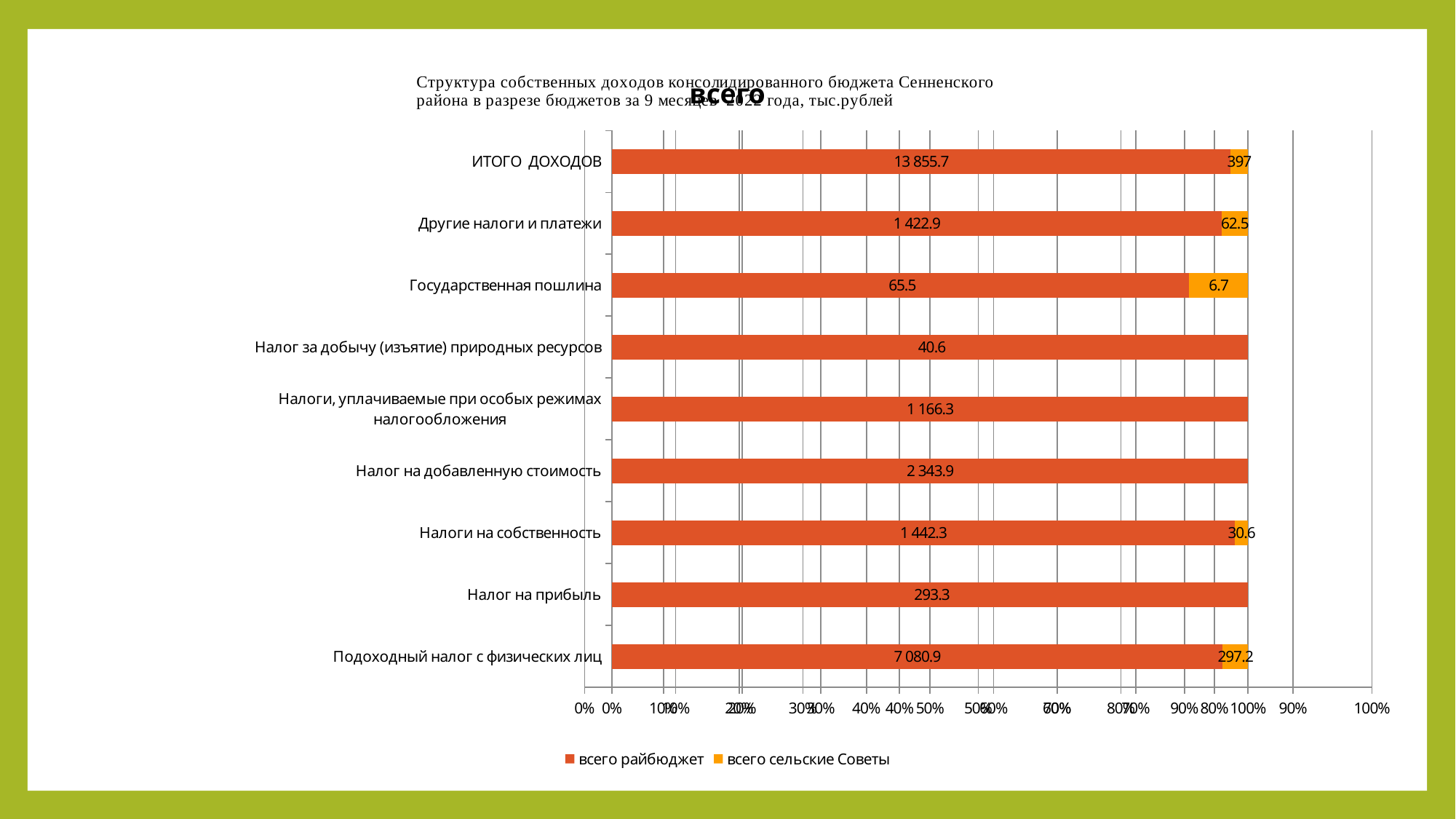
What is the value of 'всего сельские Советы' for 'Налоги на собственность'? 30.6 Which series is shown in yellow in the legend? всего сельские Советы How many categories are plotted on the chart? 9 What is the value of 'всего сельские Советы' for 'ИТОГО ДОХОДОВ'? 397 Which is larger for 'всего райбюджет': 'Налог на прибыль' or 'Налоги на собственность'? Налоги на собственность What is the difference between the 'всего сельские Советы' values for 'Подоходный налог с физических лиц' and 'Другие налоги и платежи'? 234.7 What is the value of 'всего райбюджет' for 'Подоходный налог с физических лиц'? 7 080.9 What type of chart is shown on the slide? bar chart Which category has the lowest 'всего райбюджет' value? Налог за добычу (изъятие) природных ресурсов What is the value of 'всего сельские Советы' for 'Государственная пошлина'? 6.7 How many series does the legend list? 2 What is the value of 'всего райбюджет' for 'Налог на добавленную стоимость'? 2 343.9